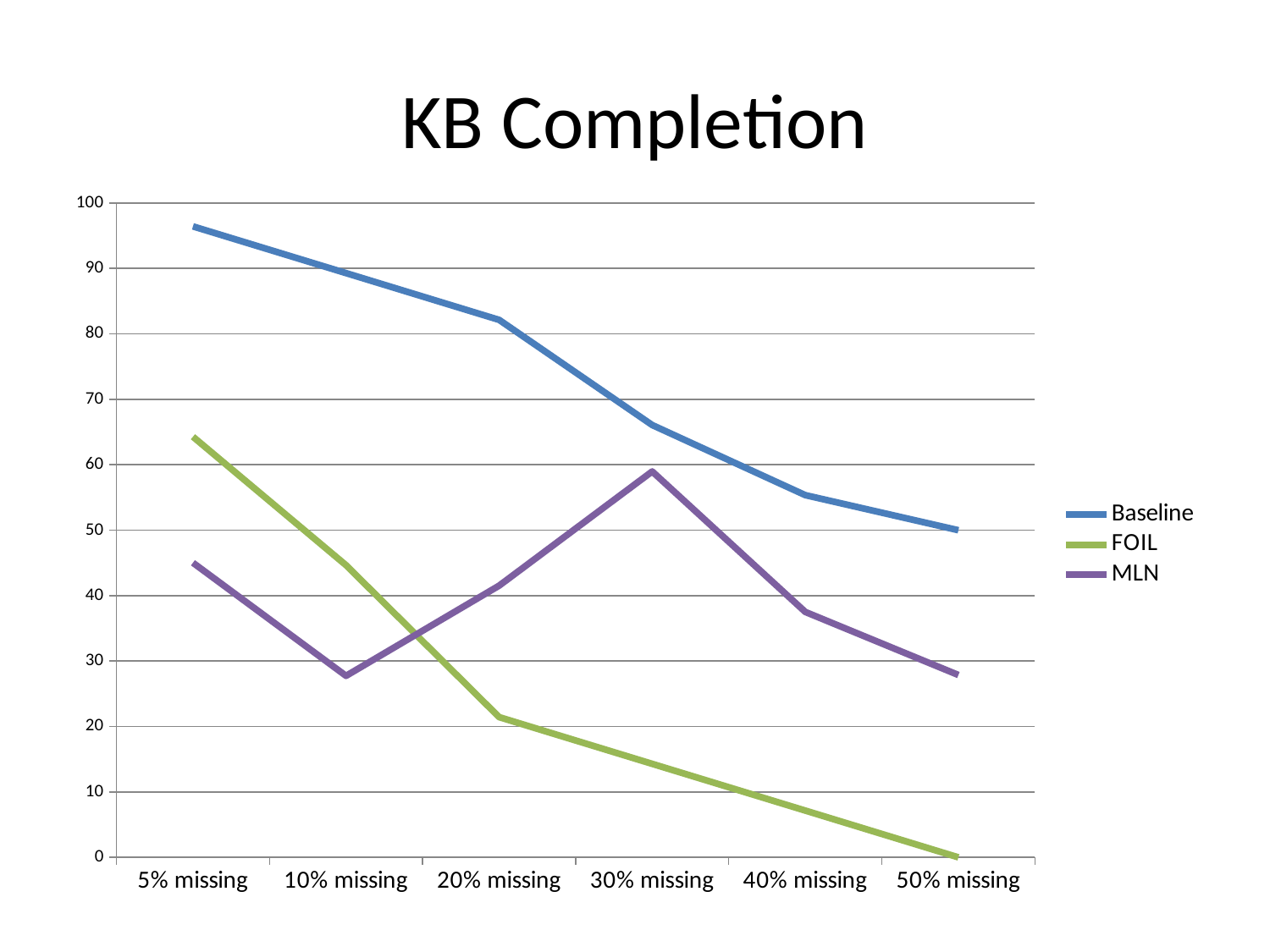
How many categories are shown on the x axis? 6 What is the title of the chart? KB Completion What kind of chart is shown on the slide? line chart Is the FOIL value at 20% missing greater or less than 30? less Does the Baseline series rise or fall from 5% missing to 50% missing? fall Is the MLN value at 30% missing greater or less than 50? greater Is the Baseline value at 5% missing greater or less than 90? greater What is the FOIL value at 50% missing? 0 How many series does the legend list? 3 What is the Baseline value at 50% missing? 50 At 20% missing, which is larger, the MLN value or the FOIL value? MLN At which category does the MLN series reach its highest value? 30% missing